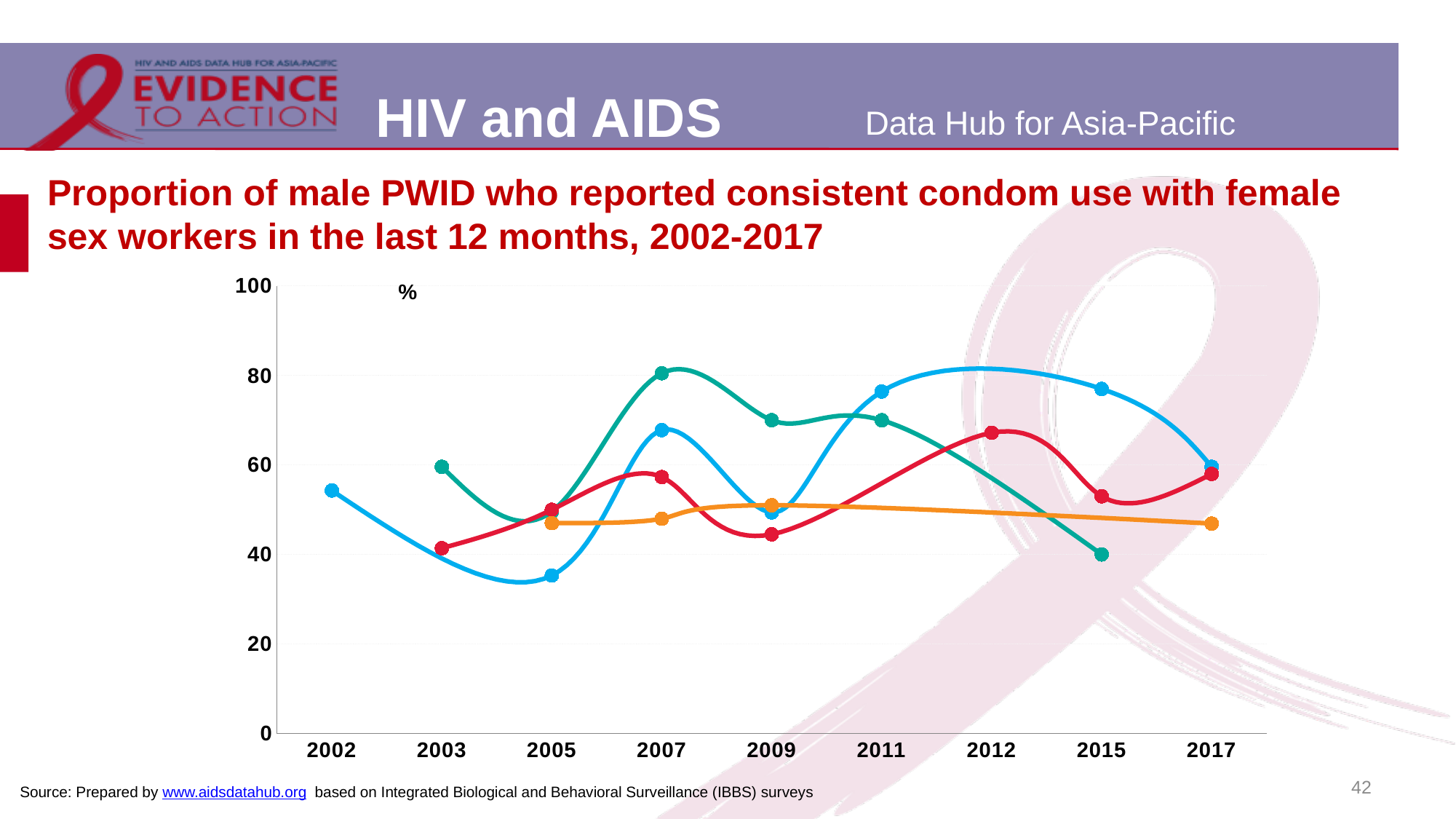
What kind of chart is shown on the slide? line chart Is the value of the blue line in 2005 greater or less than 40? less What unit is shown at the top of the y axis? % Is the value of the blue line in 2011 greater or less than 60? greater How many years are labelled on the x axis of the chart? 9 In 2015, which line has the higher value, the blue line or the green line? blue line In 2007, which line has the higher value, the green line or the blue line? green line Is the value of the green line in 2007 greater or less than 60? greater How many coloured lines are plotted on the chart? 4 In which year does the green line reach its highest value? 2007